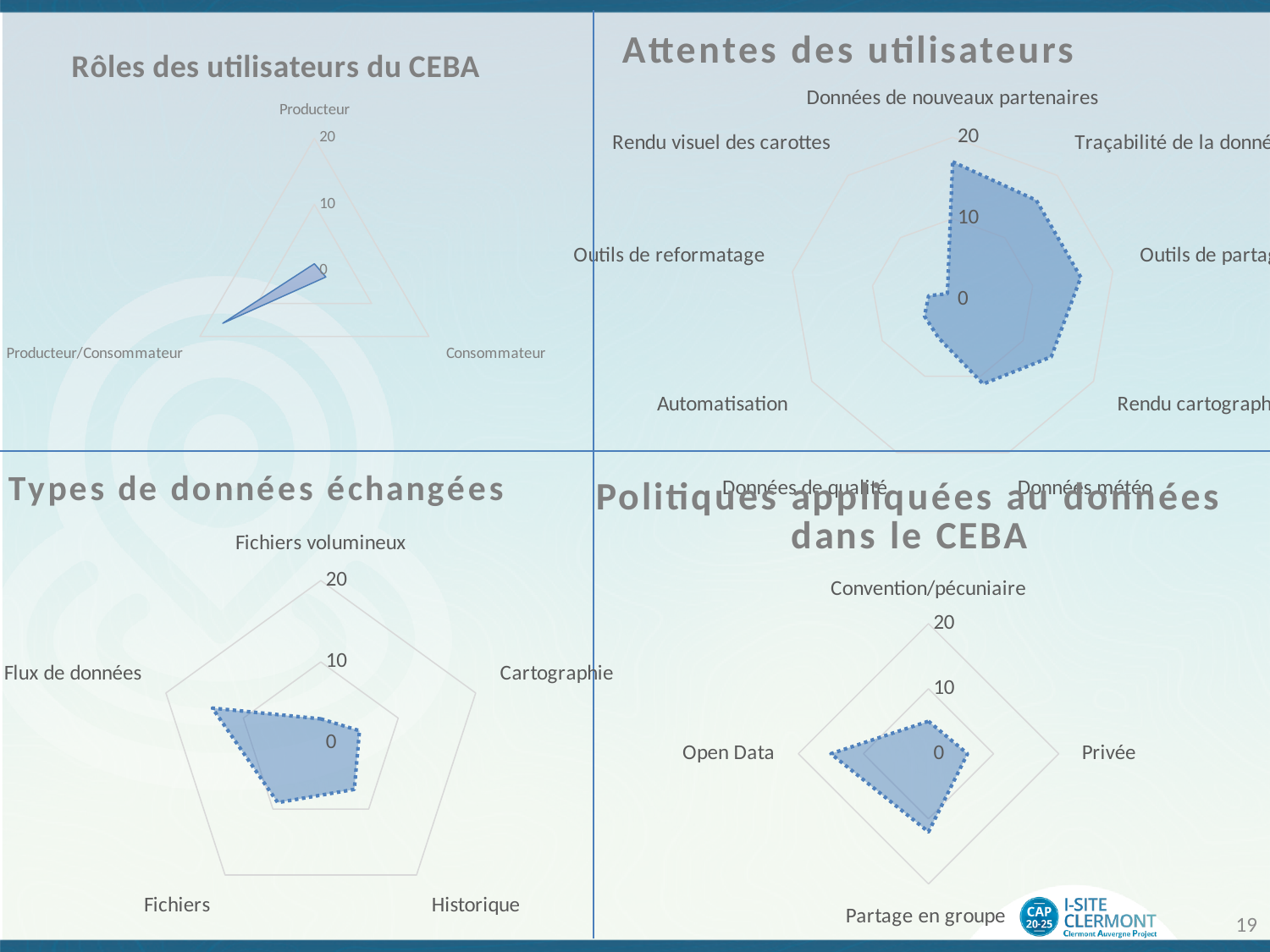
In the 'Politiques appliquées au données dans le CEBA' chart, is the value for Privée greater or less than 10? less In the 'Politiques appliquées au données dans le CEBA' chart, which category has the highest value? Open Data In the 'Attentes des utilisateurs' chart, is the value for Données de nouveaux partenaires greater or less than 10? greater What kind of chart is the 'Rôles des utilisateurs du CEBA' chart? Radar chart How many categories does the 'Rôles des utilisateurs du CEBA' chart have? 3 In the 'Rôles des utilisateurs du CEBA' chart, which category has the highest value? Producteur/Consommateur In the 'Types de données échangées' chart, which category has the highest value? Flux de données In the 'Attentes des utilisateurs' chart, is the value for Outils de reformatage greater or less than 10? less How many categories does the 'Types de données échangées' chart have? 5 How many categories does the 'Politiques appliquées au données dans le CEBA' chart have? 4